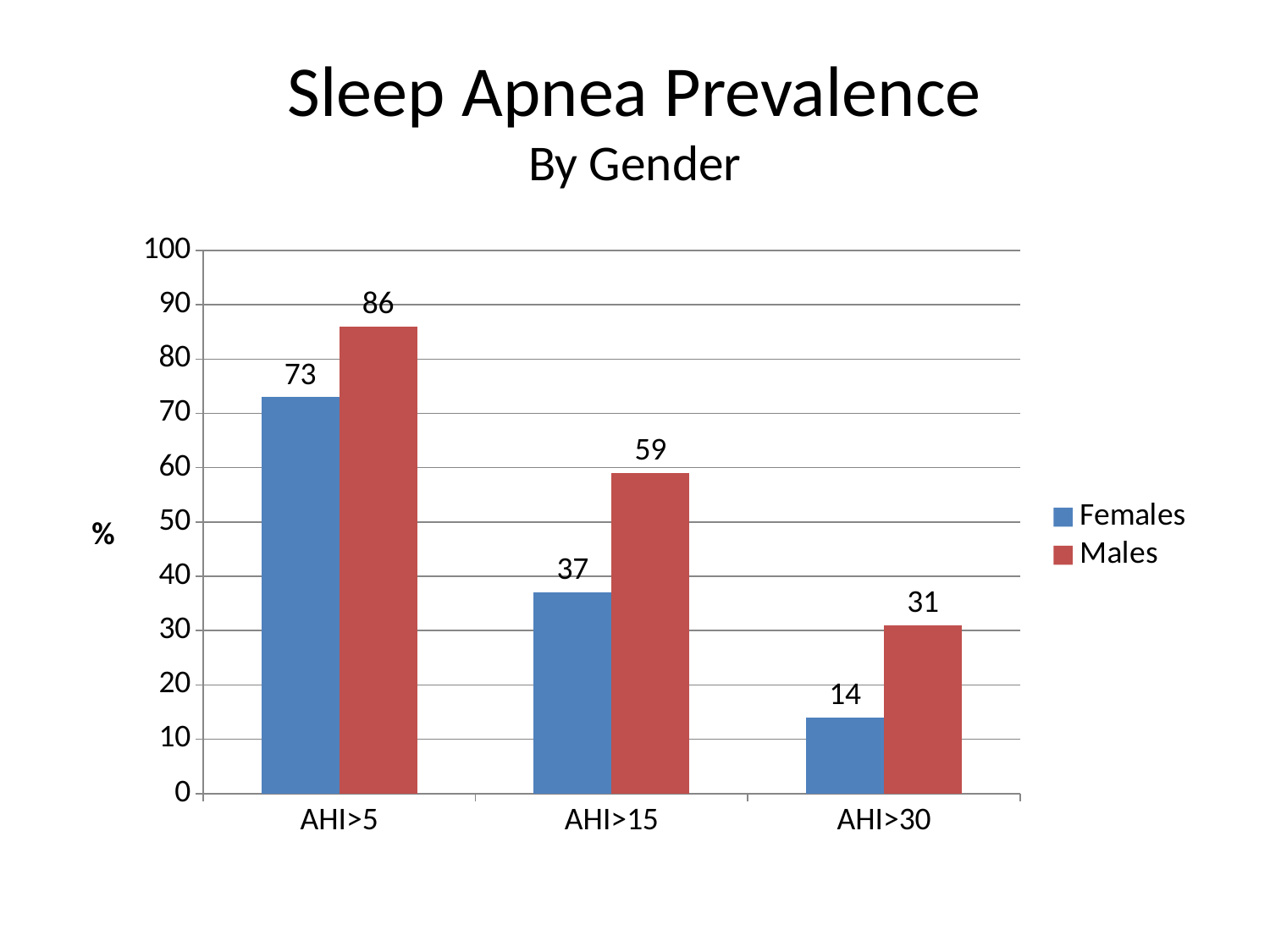
What is the difference between the Males values at AHI>15 and AHI>30? 28 What is the value for Females at AHI>5? 73 Which is larger at AHI>15, the Females value or the Males value? Males Which category has the highest value for Males? AHI>5 How many series does the legend list? 2 What is the value for Females at AHI>30? 14 Do the Females values rise or fall from AHI>5 to AHI>30? Fall What is the value for Males at AHI>15? 59 How many categories are shown on the x axis? 3 Which category has the lowest value for Females? AHI>30 What kind of chart is shown on the slide? Bar chart What is the difference between the Males and Females values at AHI>5? 13